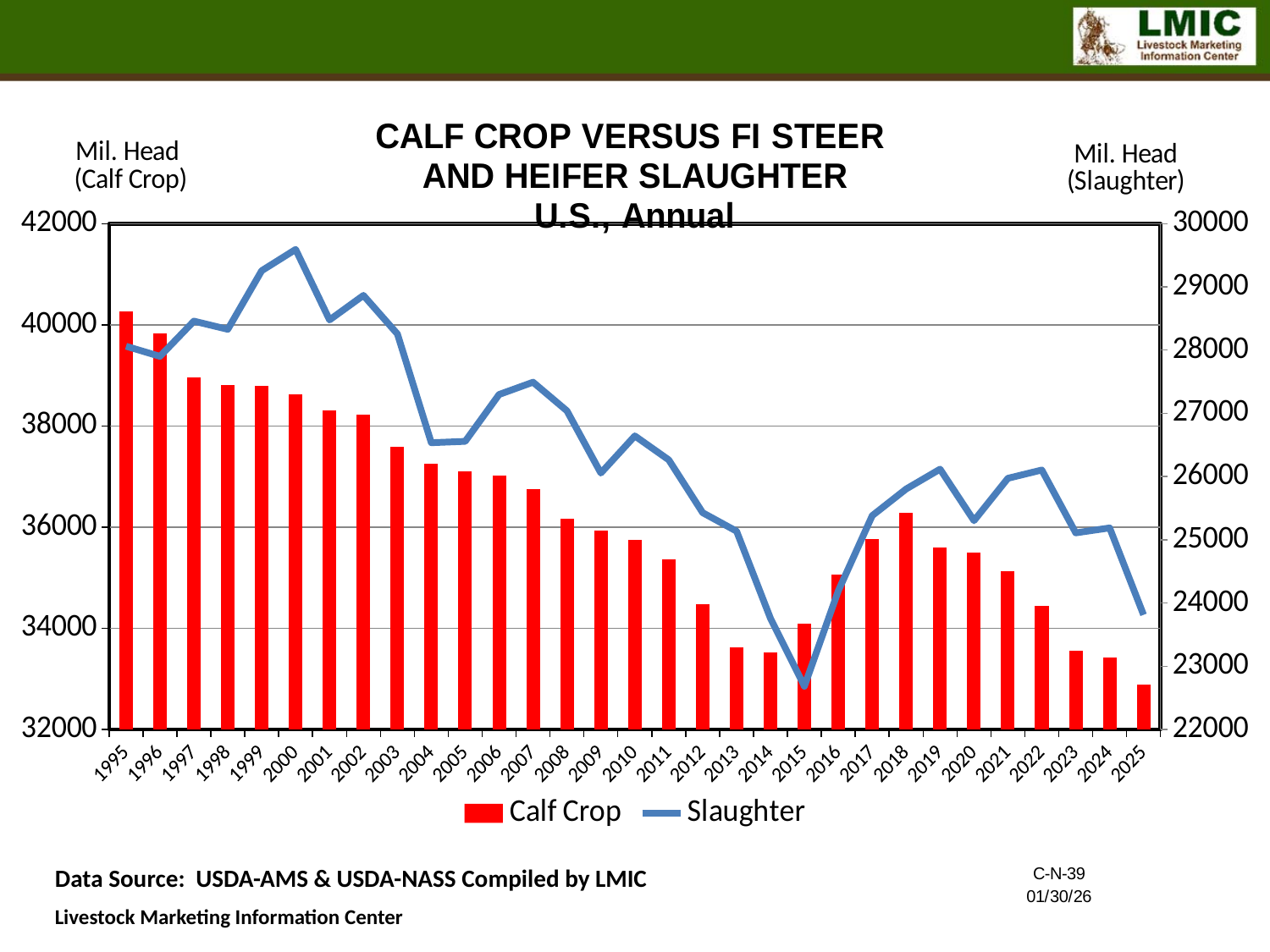
What kind of chart is this? Combination bar and line chart In which year does the Slaughter line reach its highest point? 2000 Is the Calf Crop value for 2025 greater or less than 34000? less In which year is the Calf Crop bar the lowest? 2025 Does the Calf Crop series generally rise or fall from 1995 to 2013? fall In which year is the Calf Crop bar the highest? 1995 What are the two series named in the legend? Calf Crop and Slaughter Which year has the larger Calf Crop value, 2013 or 2018? 2018 Is the Slaughter value for 2015 greater or less than 23000? less How many series does the legend list? 2 How many years are shown on the x axis? 31 In which year does the Slaughter line reach its lowest point? 2015